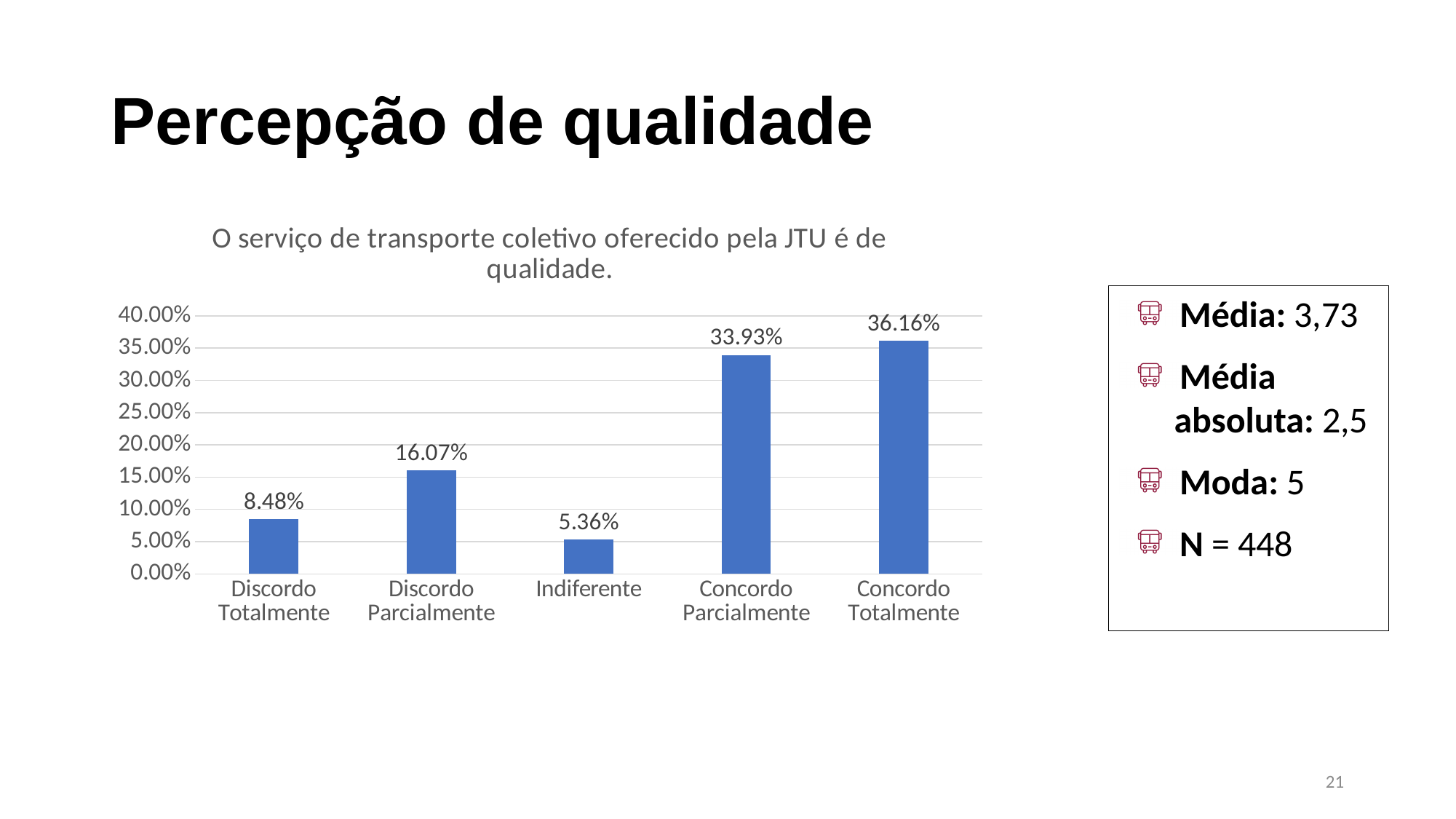
Which category has the highest value? Concordo Totalmente What is the value for Indiferente? 5.36% What is the value for Discordo Totalmente? 8.48% How many categories are shown on the x axis? 5 What is the title of the chart? O serviço de transporte coletivo oferecido pela JTU é de qualidade. Is the value for Concordo Parcialmente greater or less than 30.00%? greater What is the difference between Discordo Parcialmente and Discordo Totalmente? 7.59% What is the value for Concordo Parcialmente? 33.93% What is the difference between Concordo Totalmente and Concordo Parcialmente? 2.23% What kind of chart is shown on the slide? bar chart Which is larger, Discordo Parcialmente or Indiferente? Discordo Parcialmente Which category has the lowest value? Indiferente